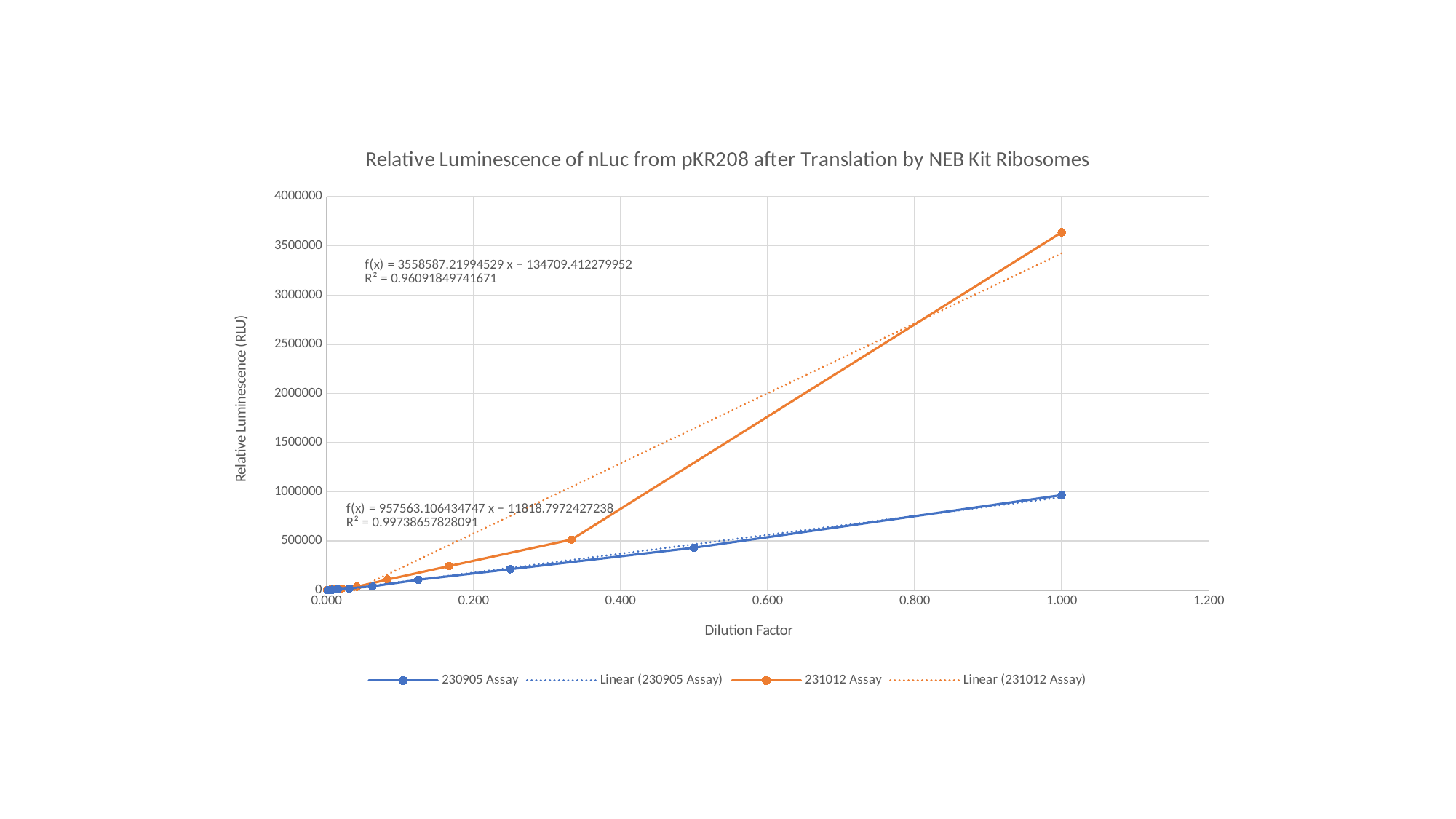
What is the label of the y axis? Relative Luminescence (RLU) What kind of chart is shown on the slide? line chart At a dilution factor of 1.000, which series has the higher value, 230905 Assay or 231012 Assay? 231012 Assay Is the value for the 230905 Assay at a dilution factor of 1.000 greater or less than 1000000? less What R² value is printed for the trendline of the 231012 Assay? 0.96091849741671 What R² value is printed for the trendline of the 230905 Assay? 0.99738657828091 What is the title of the chart? Relative Luminescence of nLuc from pKR208 after Translation by NEB Kit Ribosomes Is the value for the 231012 Assay at a dilution factor of 1.000 greater or less than 3500000? greater Is the value for the 230905 Assay at a dilution factor of 0.500 greater or less than 500000? less Do the values for the 231012 Assay rise or fall as the dilution factor increases? rise How many entries does the legend list? 4